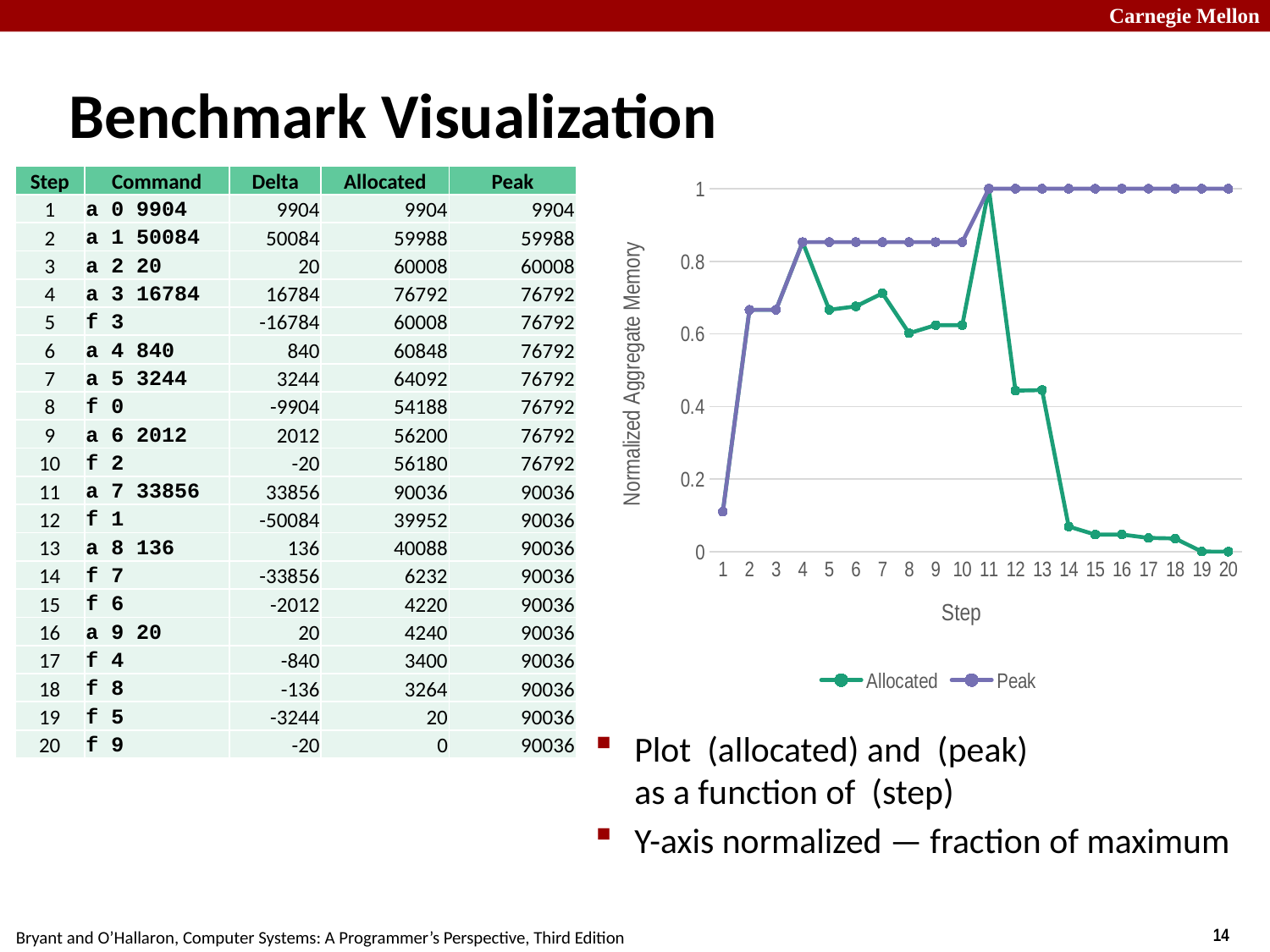
What are the two series named in the chart legend? Allocated and Peak What is the label of the chart's y axis? Normalized Aggregate Memory At step 5, which series has the larger value, Allocated or Peak? Peak How many steps are plotted along the x axis of the chart? 20 What is the value of the Peak series at step 15? 1 How many series does the chart legend list? 2 Is the value of the Allocated series at step 1 greater or less than 0.2? less What is the value of the Allocated series at step 20? 0 At which step does the Allocated series reach its highest value? 11 What kind of chart is shown on the slide? line chart At which step is the Peak series at its lowest value? 1 Is the value of the Peak series at step 4 greater or less than 0.8? greater